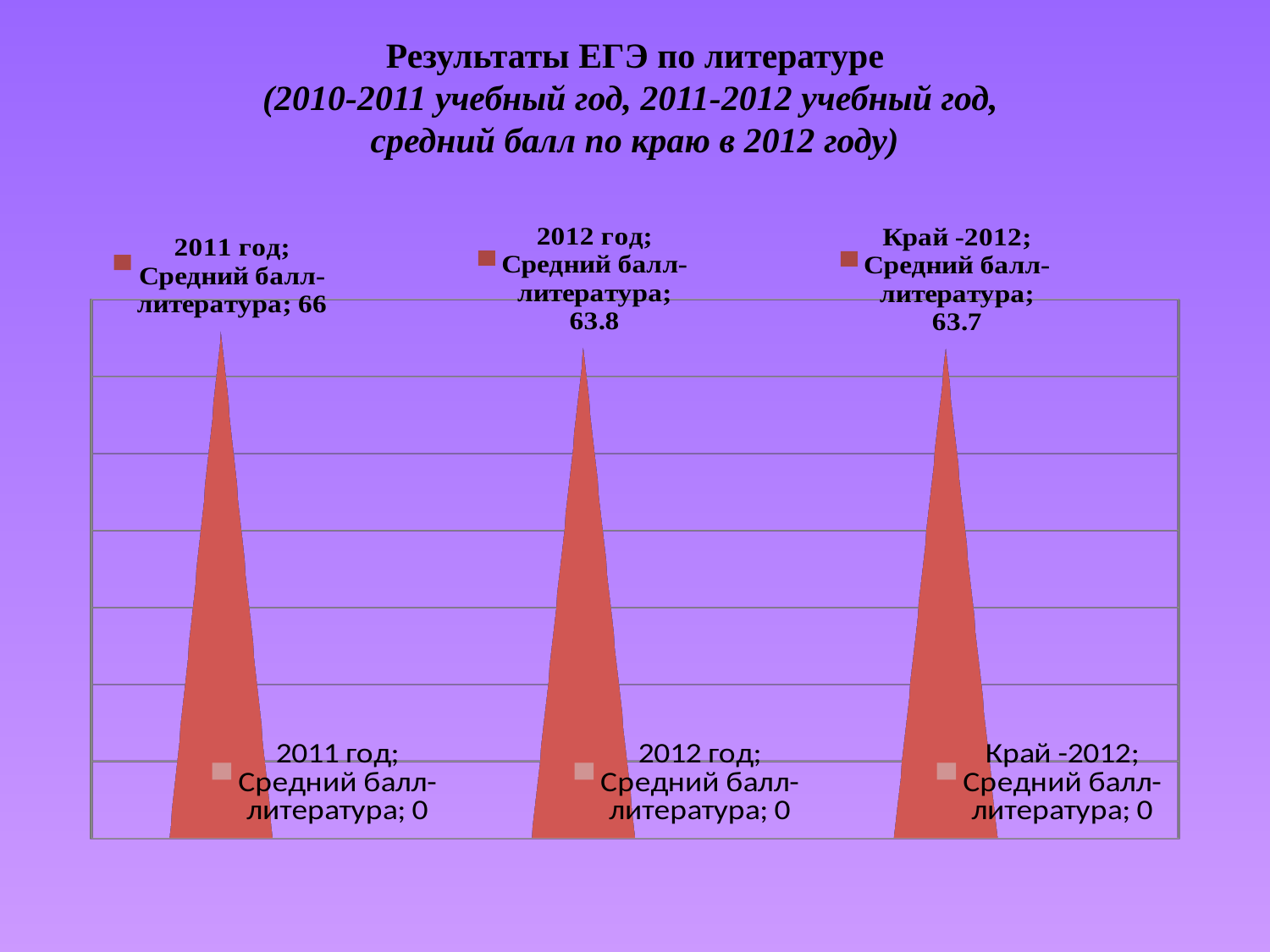
What is the average literature score (Средний балл-литература) for 2011 год? 66 Which is larger, the average literature score for 2011 год or for 2012 год? 2011 год What is the difference between the average literature score for 2011 год and for Край -2012? 2.3 What is the average literature score for Край -2012? 63.7 Which category has the lowest average literature score according to the data labels? Край -2012 What is the first line of the slide title? Результаты ЕГЭ по литературе What is the average literature score for 2012 год? 63.8 What is the difference between the average literature score for 2011 год and for 2012 год? 2.2 Which category has the highest average literature score? 2011 год How many categories are plotted on the chart? 3 What is the difference between the average literature score for 2012 год and for Край -2012? 0.1 Do the average literature scores rise or fall from left to right across the chart? fall